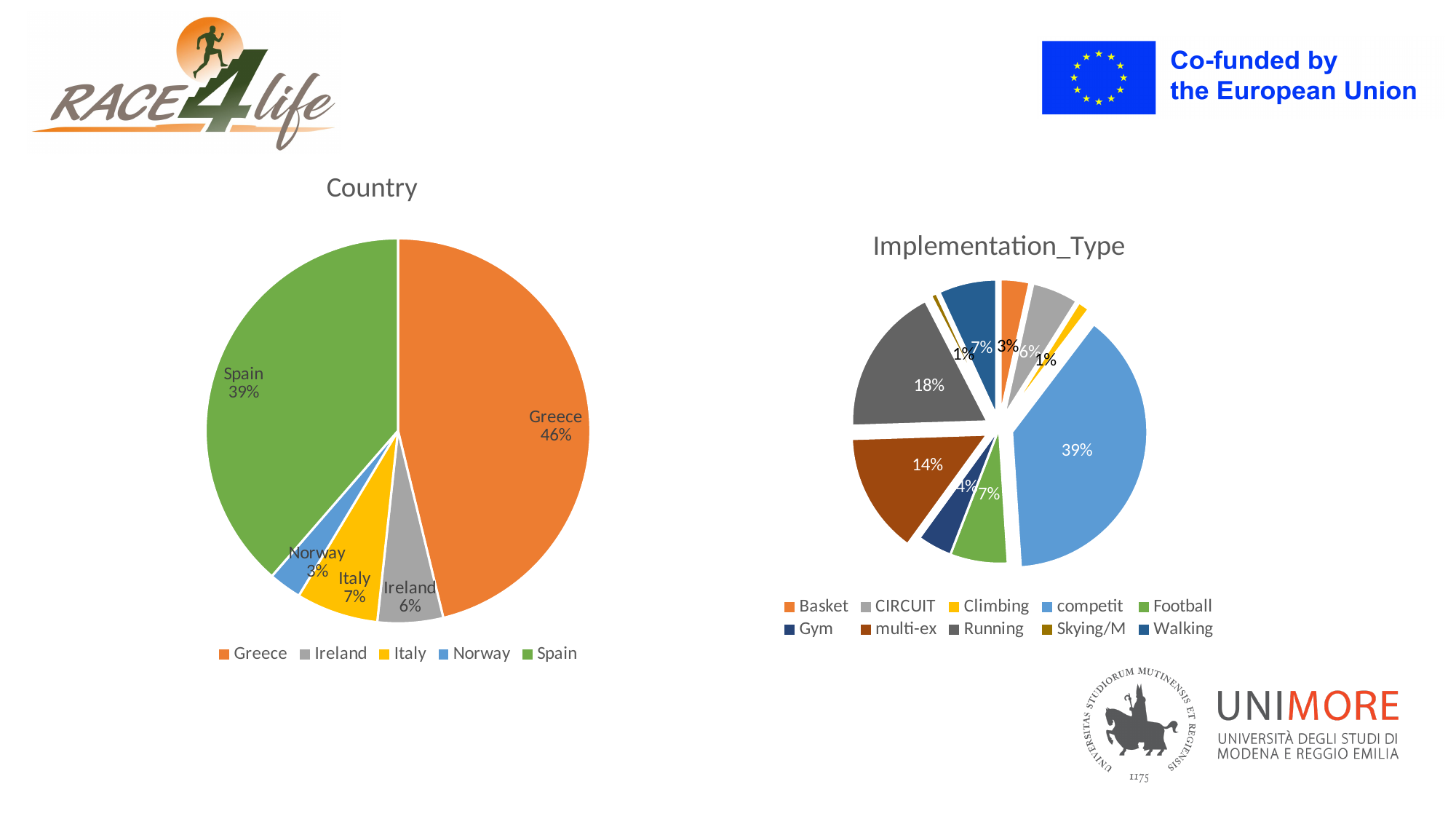
In the Implementation_Type chart, which implementation type has the largest share? competit How many implementation types does the legend of the Implementation_Type chart list? 10 In the Country chart, what share does Greece have? 46% What kind of chart is the Implementation_Type chart? Pie chart In the Country chart, which has the larger share, Italy or Ireland? Italy In the Country chart, what is the difference in percentage points between Greece and Spain? 7 In the Implementation_Type chart, what share does Running have? 18% In the Country chart, which country has the largest share? Greece In the Country chart, what share does Spain have? 39% In the Country chart, which country has the smallest share? Norway In the Implementation_Type chart, what share does competit have? 39% How many countries are shown in the Country chart? 5